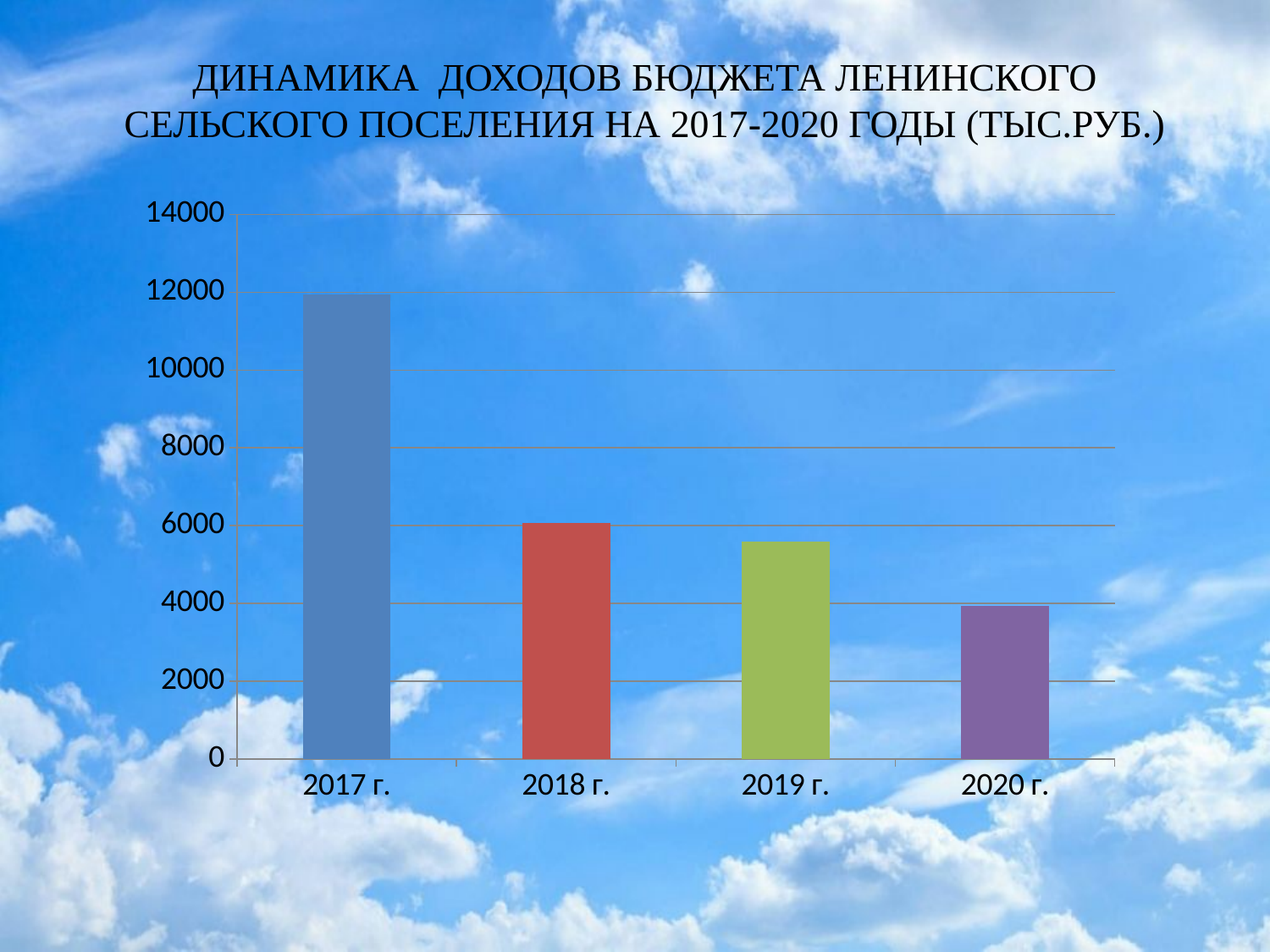
Which year has the lowest budget income in the chart? 2020 г. Is the value for 2020 г. greater or less than 2000? greater Is the value for 2017 г. greater or less than 10000? greater Do the values rise or fall from 2017 г. to 2020 г. along the x axis? fall What kind of chart is shown on the slide? bar chart Which year has the highest budget income in the chart? 2017 г. In what units are the budget incomes given according to the slide title? тыс.руб. How many years (categories) are shown on the x axis of the chart? 4 Is the value for 2018 г. greater or less than 4000? greater Which is larger, the value for 2019 г. or the value for 2020 г.? 2019 г. Which is larger, the value for 2017 г. or the value for 2018 г.? 2017 г.